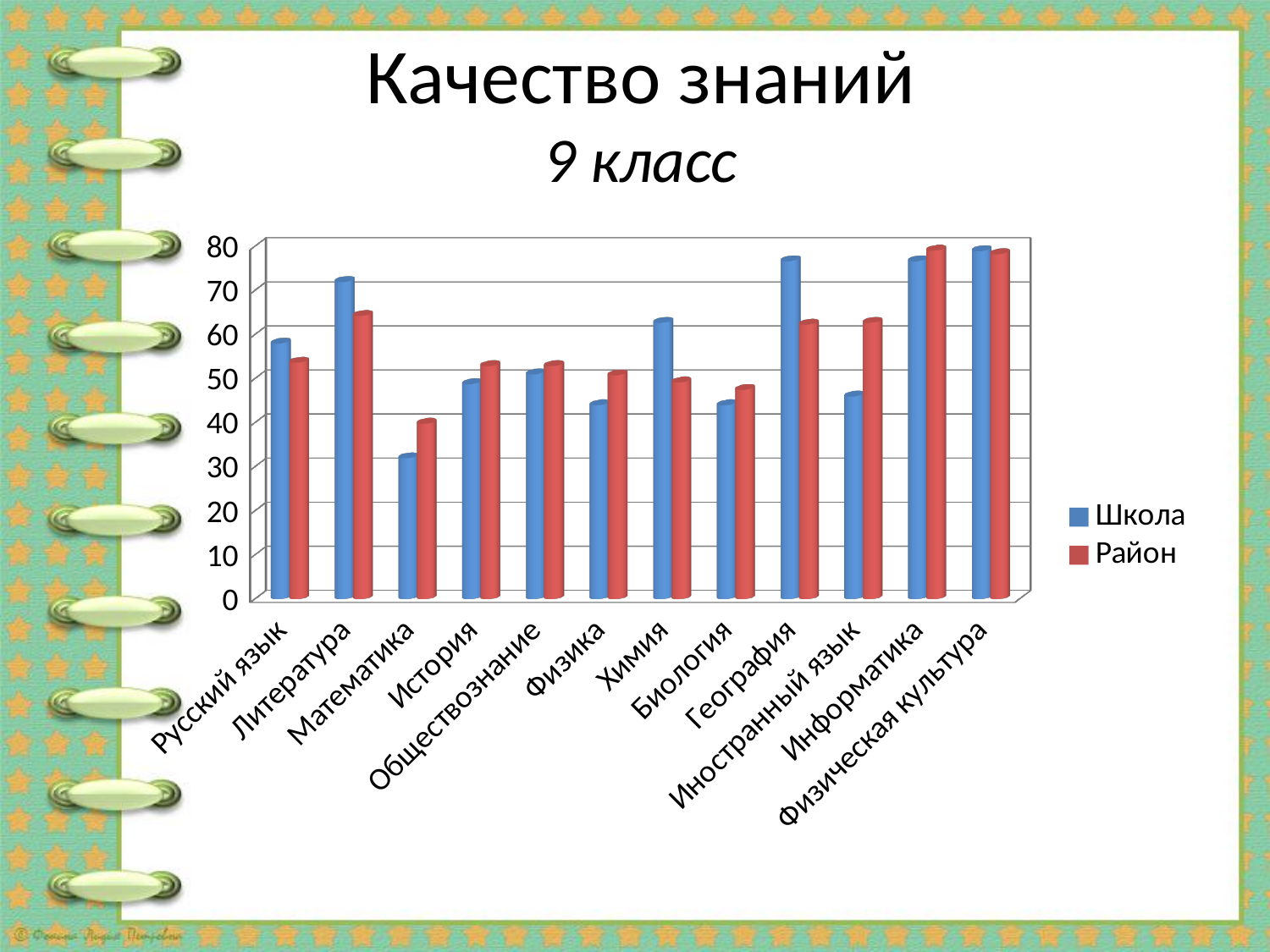
What are the two legend entries of the chart? Школа and Район Is the Школа value for Физика greater or less than 50? less Is the Район value for Иностранный язык greater or less than 60? greater For География, which is larger: Школа or Район? Школа Which subject has the lowest value for Школа? Математика Is the Школа value for Литература greater or less than 70? greater How many subjects (categories) are shown on the x axis? 12 How many series does the legend list? 2 For Иностранный язык, which is larger: Школа or Район? Район What kind of chart is shown on the slide? bar chart Which subject has the lowest value for Район? Математика